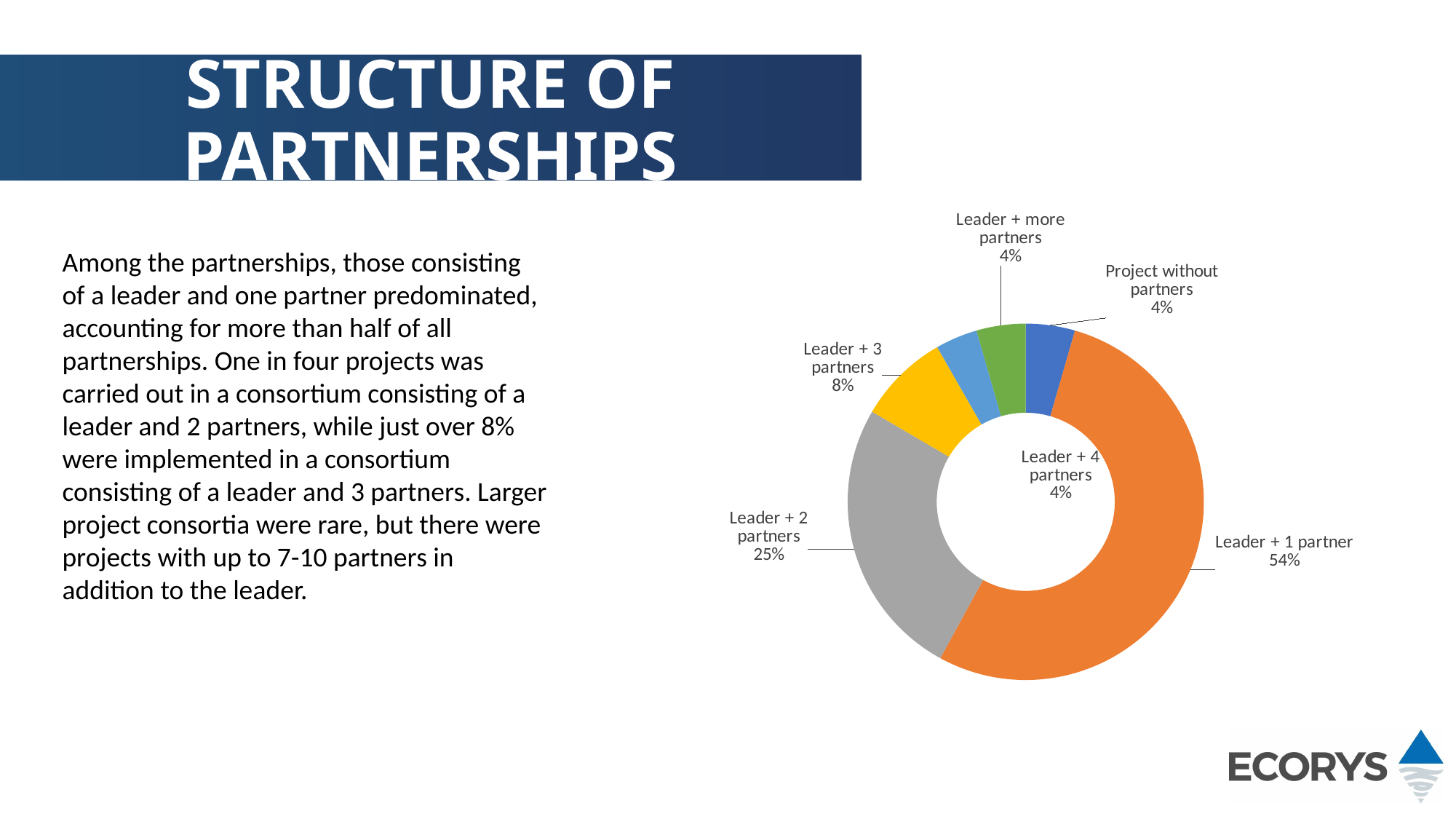
Which is larger, the share for Leader + 3 partners or the share for Leader + 4 partners? Leader + 3 partners What is the difference in percentage points between Leader + 2 partners and Leader + 3 partners? 17 What percentage is shown for Leader + 3 partners? 8% Which category has the largest share of the chart? Leader + 1 partner What colour is the Leader + 1 partner slice? Orange What is the difference in percentage points between Leader + 1 partner and Leader + 2 partners? 29 What kind of chart is shown on the slide? Doughnut (pie) chart What percentage is shown for Leader + more partners? 4% How many categories are shown in the chart? 6 What percentage is shown for Leader + 2 partners? 25% What share of partnerships consists of a leader and 1 partner? 54% What share is shown for Project without partners? 4%